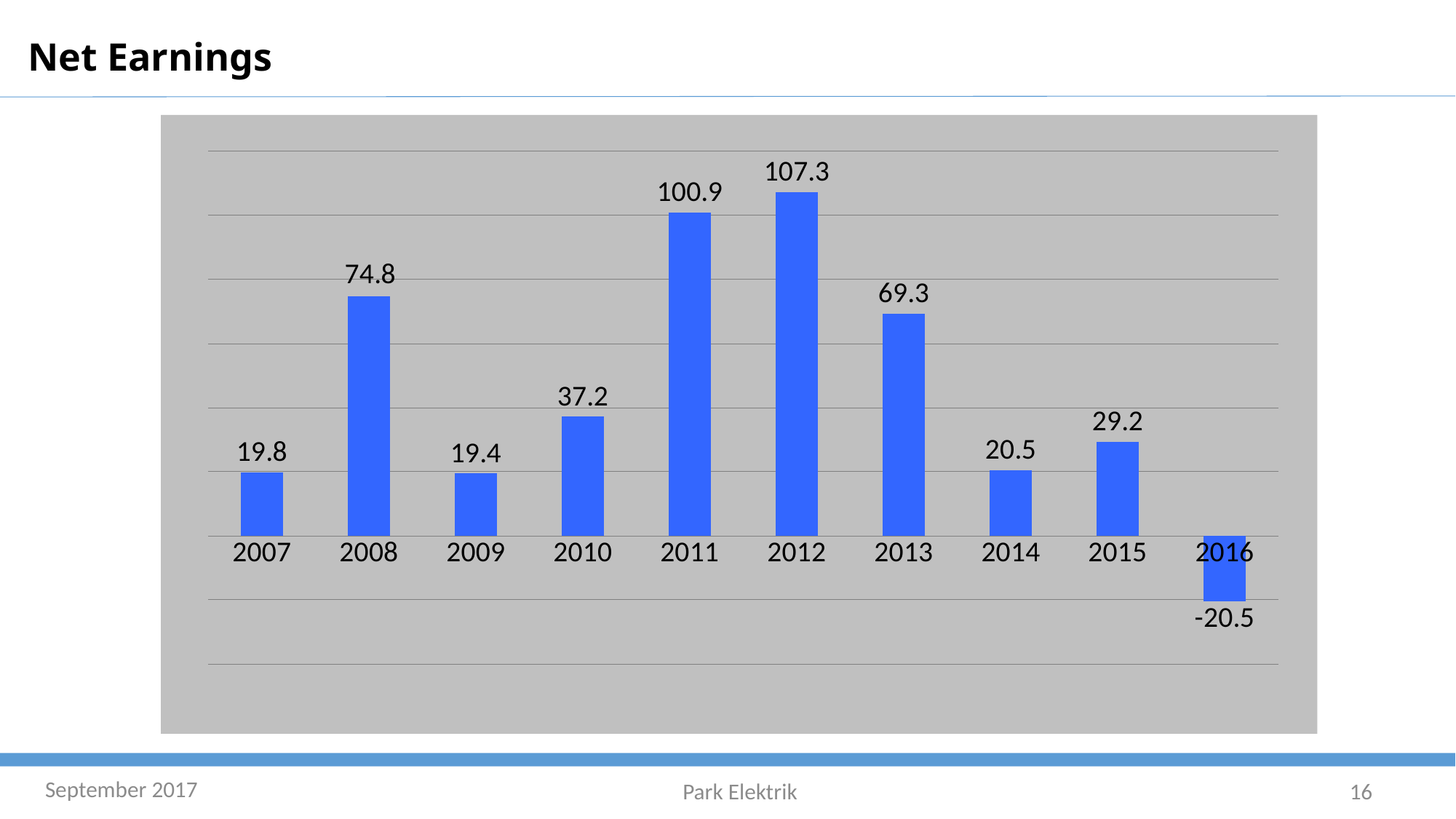
What is the difference between the net earnings for 2012 and 2011? 6.4 How many years are shown on the chart? 10 What kind of chart is shown on the slide? Bar chart Which year has the highest net earnings? 2012 Which year has the lowest net earnings? 2016 What is the difference between the net earnings for 2008 and 2013? 5.5 Which year has higher net earnings, 2008 or 2013? 2008 What is the net earnings value for 2010? 37.2 What is the net earnings value for 2012? 107.3 Do the net earnings rise or fall from 2012 to 2016? Fall Which year has higher net earnings, 2014 or 2015? 2015 What is the net earnings value for 2016? -20.5